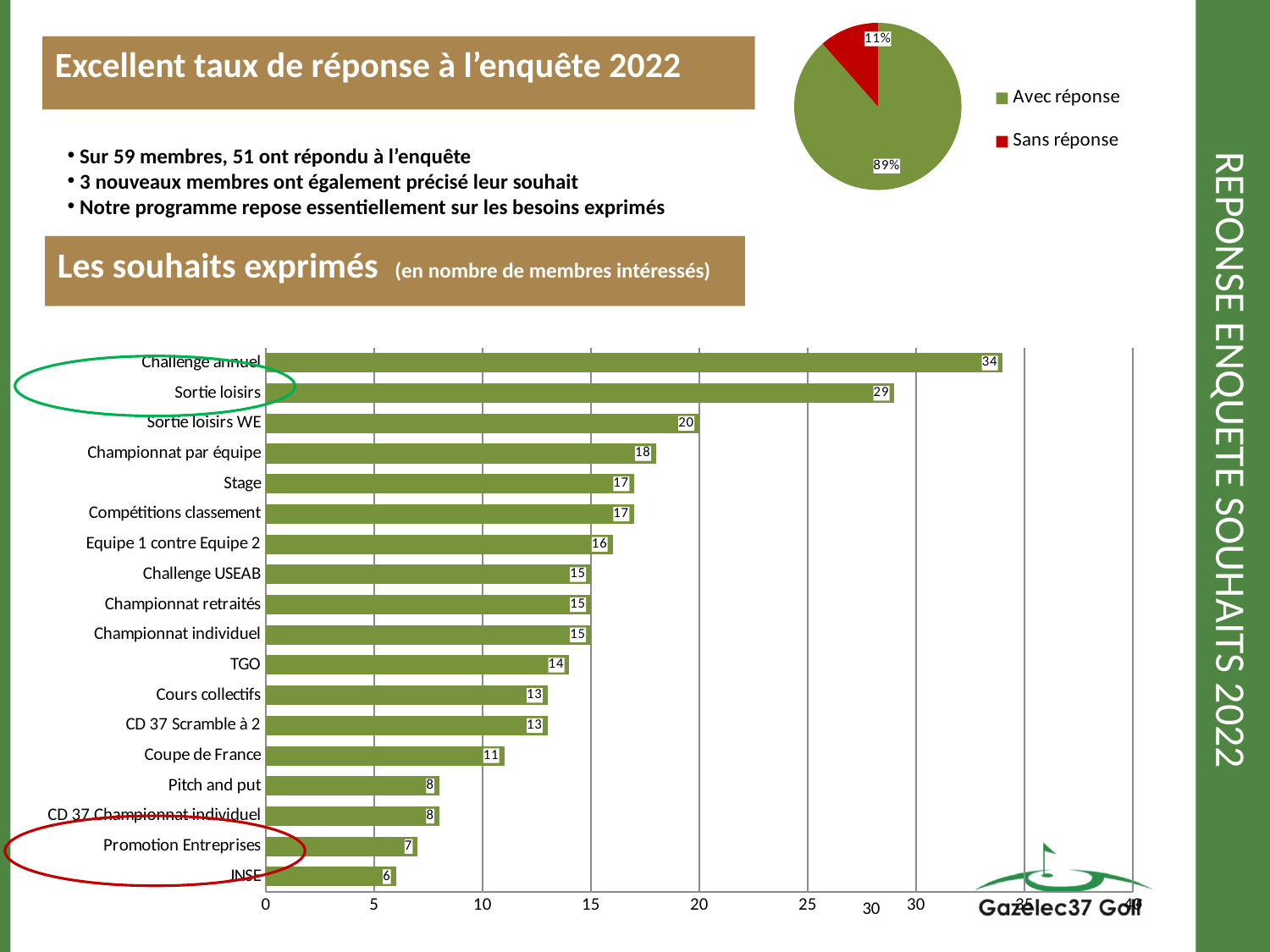
How many entries does the legend of the pie chart at the top right list? 2 In the "Les souhaits exprimés" bar chart, what is the value for "Championnat par équipe"? 18 In the "Les souhaits exprimés" bar chart, what is the value for "Challenge annuel"? 34 In the "Les souhaits exprimés" bar chart, which category has the highest value? Challenge annuel What kind of chart is the large chart under "Les souhaits exprimés"? Bar chart In the "Les souhaits exprimés" bar chart, what is the difference between "Challenge annuel" and "Sortie loisirs"? 5 In the "Les souhaits exprimés" bar chart, which category has the lowest value? JNSE In the "Les souhaits exprimés" bar chart, which is larger: "Sortie loisirs WE" or "TGO"? Sortie loisirs WE In the "Les souhaits exprimés" bar chart, what is the value for "Coupe de France"? 11 In the pie chart at the top right, what share of members is shown for "Avec réponse"? 89% In the pie chart at the top right, what share is shown for "Sans réponse"? 11% How many categories are shown in the "Les souhaits exprimés" bar chart? 18